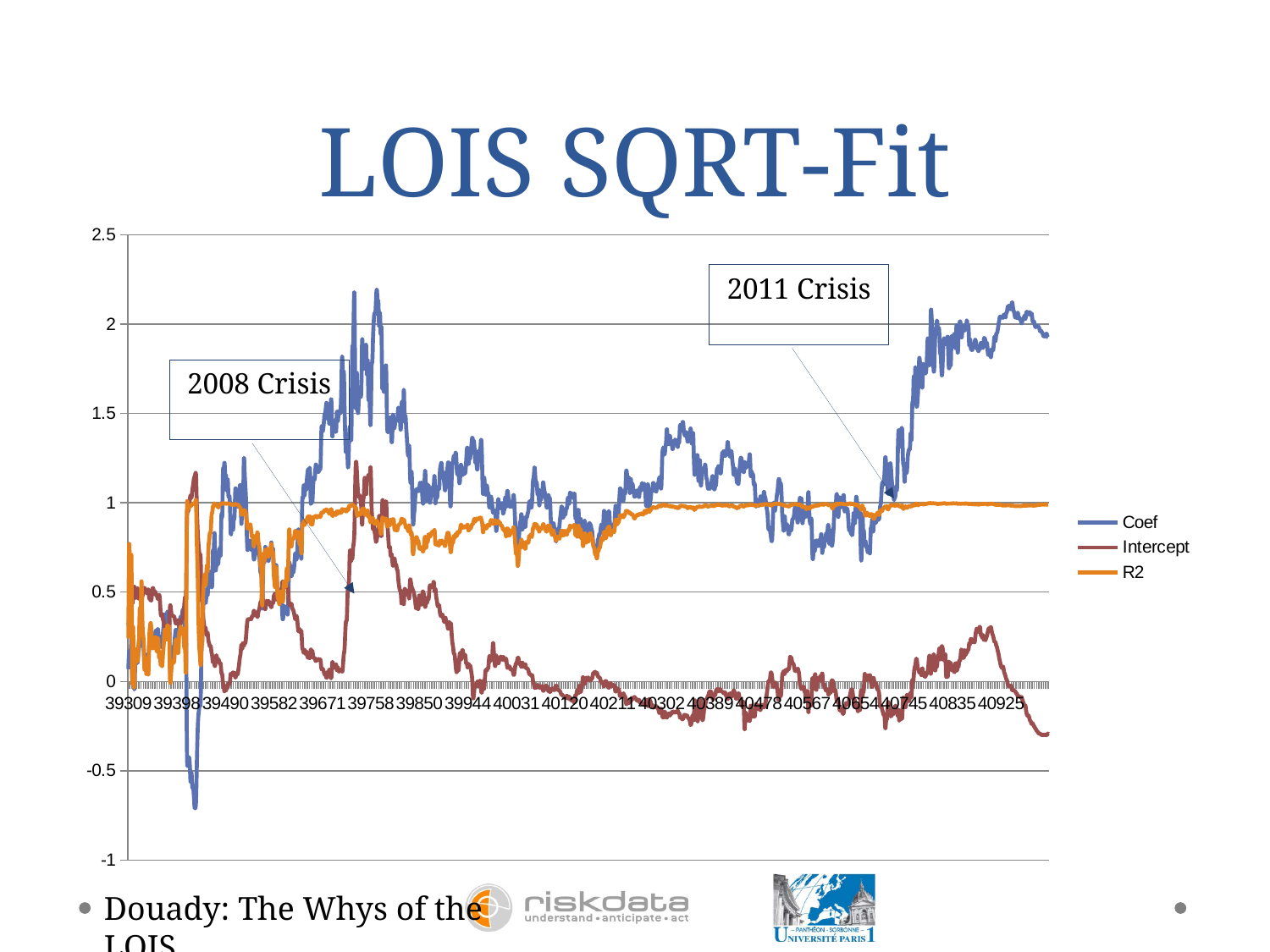
Is the peak value of the Coef series greater or less than 2? greater Does the Intercept series overall rise or fall from the left of the chart to the right? fall Is the value of the Intercept series at the right end of the chart greater or less than 0? less Does the R2 series overall rise or fall from the left of the chart to the right? rise Which series reaches the lowest value on the chart? Coef Which series is drawn in orange? R2 At the right end of the chart, which is larger, Coef or Intercept? Coef What kind of chart is shown on the slide? line chart Is the value of the Coef series at the right end of the chart greater or less than 1.5? greater Which series reaches the highest value on the chart? Coef What is the title of the chart? LOIS SQRT-Fit How many series does the legend list? 3